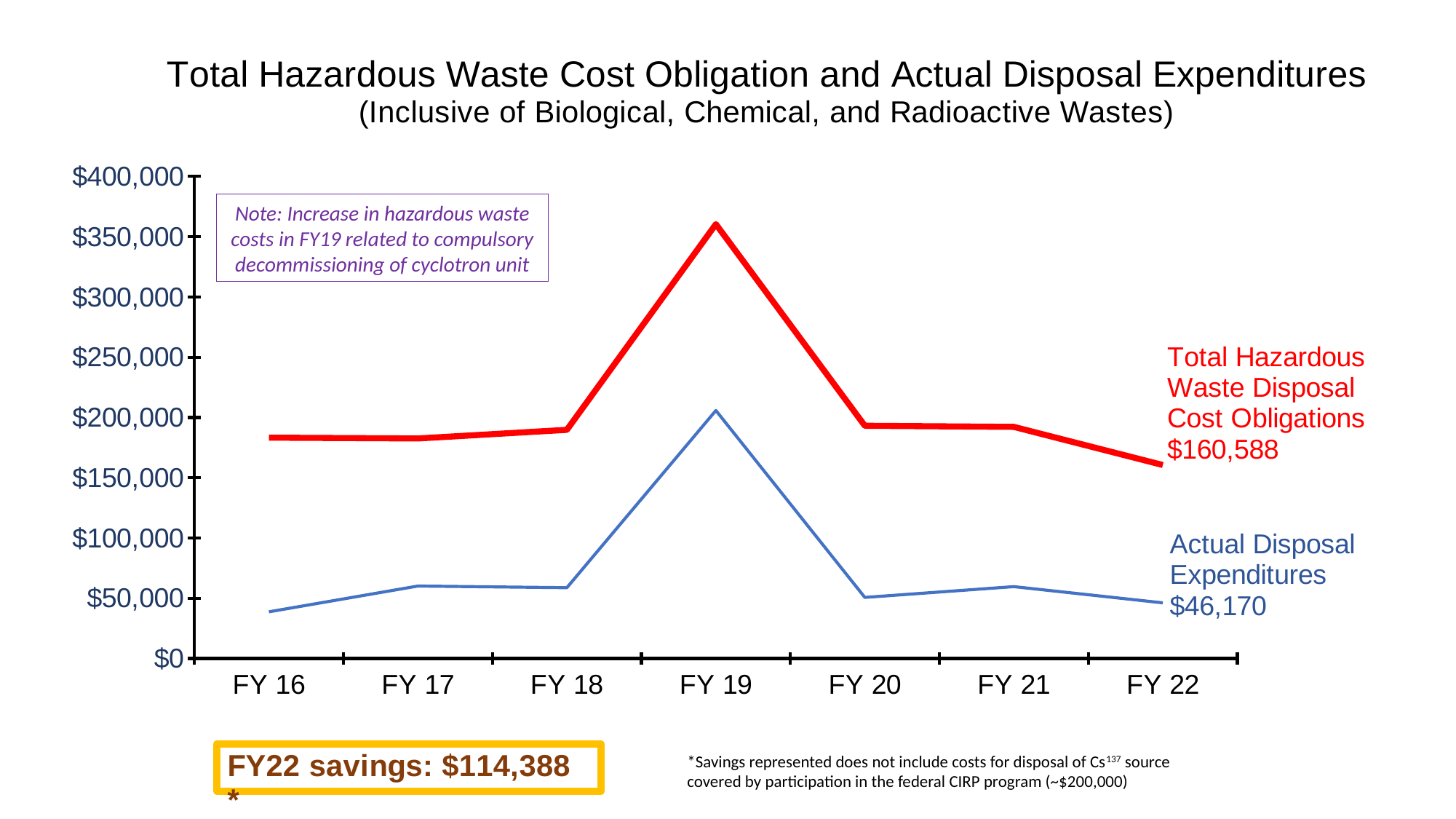
Is the value of Total Hazardous Waste Disposal Cost Obligations in FY 19 greater or less than $350,000? greater In which fiscal year do Total Hazardous Waste Disposal Cost Obligations reach their highest value? FY 19 What kind of chart is shown on the slide? line chart What is the value of Total Hazardous Waste Disposal Cost Obligations in FY 22? $160,588 What is the value of Actual Disposal Expenditures in FY 22? $46,170 What colour is the line for Total Hazardous Waste Disposal Cost Obligations? red Do Total Hazardous Waste Disposal Cost Obligations rise or fall from FY 19 to FY 22? fall Which is larger for Total Hazardous Waste Disposal Cost Obligations: FY 19 or FY 22? FY 19 How many data series are plotted on the chart? 2 In which fiscal year are Actual Disposal Expenditures highest? FY 19 Is the value of Actual Disposal Expenditures in FY 16 greater or less than $50,000? less How many fiscal years are plotted along the x axis? 7